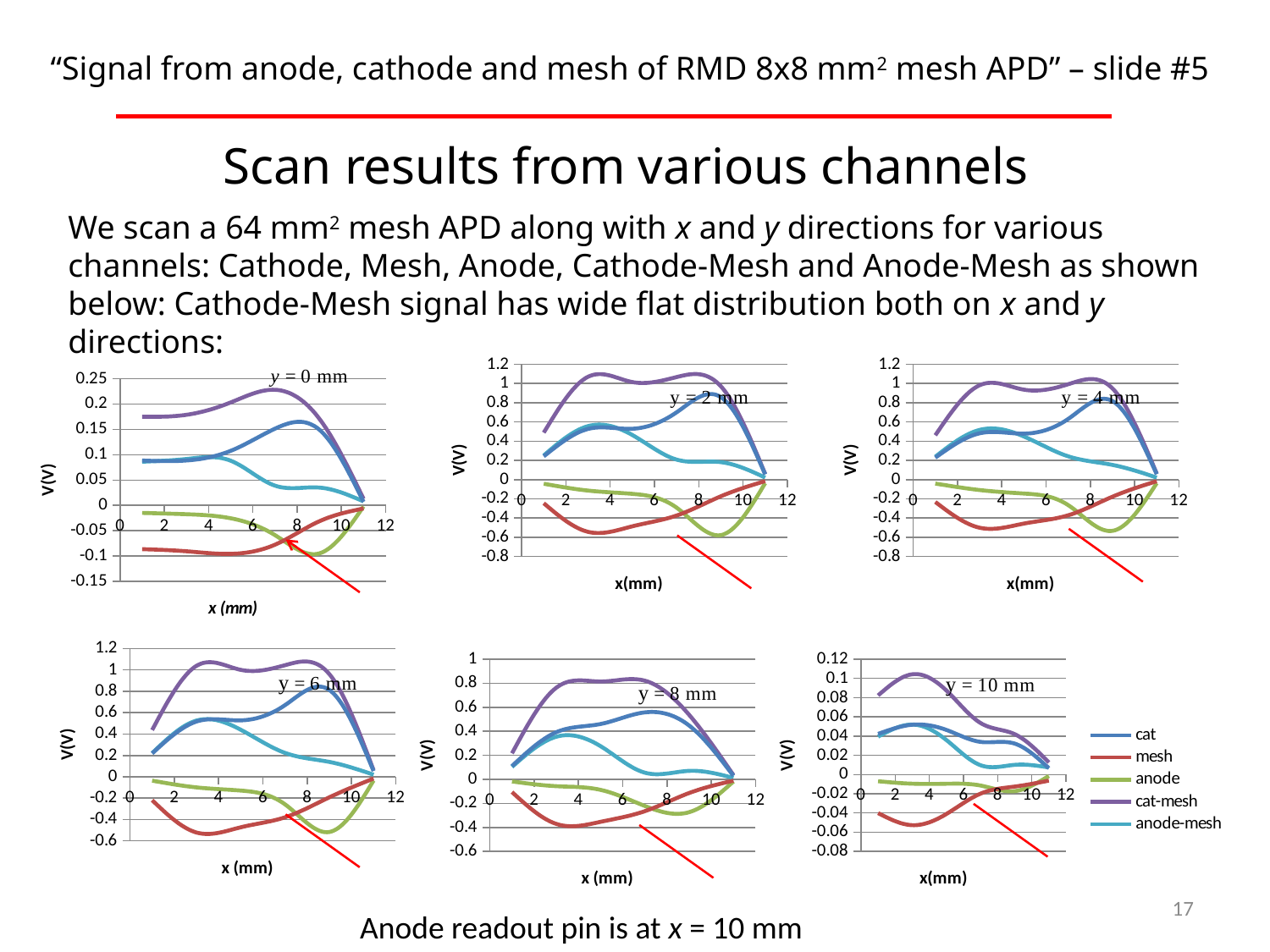
In the y = 6 mm chart, which series has the lowest value at x = 9 mm? anode In the y = 4 mm chart, is the minimum value of the mesh series greater or less than -0.4? less In the y = 2 mm chart, which series has the highest values across the x range? cat-mesh How many charts are shown on the slide? 6 In the y = 8 mm chart, at x = 2 mm, which is larger: the cat-mesh value or the anode-mesh value? cat-mesh How many series does the legend list? 5 In the y = 10 mm chart, is the peak value of the cat-mesh series greater or less than 0.08? greater What kind of chart is the y = 0 mm chart? line chart What is the y-axis label on the y = 2 mm chart? V(V) In the y = 2 mm chart, which series has the lowest value at x = 4 mm? mesh In the y = 0 mm chart, does the cat-mesh series rise or fall from x = 8 mm to x = 11 mm? fall In the y = 0 mm chart, is the peak value of the cat-mesh series greater or less than 0.2? greater